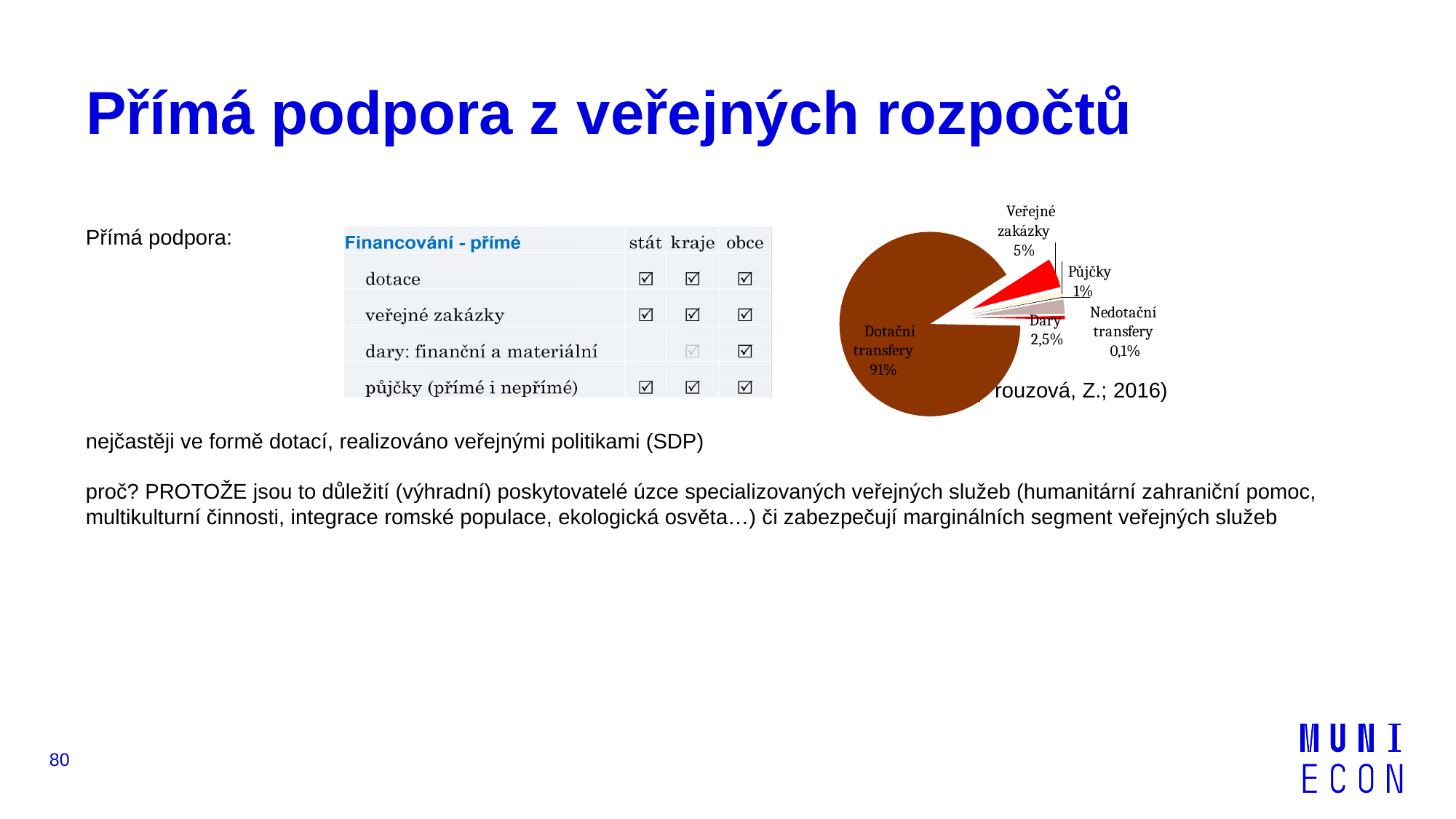
What share of the pie does Dary have? 2,5% What is the difference in percentage points between Veřejné zakázky and Půjčky? 4 What kind of chart is shown on the slide? pie chart What colour is the Dotační transfery slice in the pie chart? brown What share of the pie does Veřejné zakázky have? 5% Which is larger in the pie chart, Veřejné zakázky or Dary? Veřejné zakázky How many slices does the pie chart have? 6 Which slice of the pie chart is the smallest? Nedotační transfery Which slice of the pie chart is the largest? Dotační transfery What share of the pie does Půjčky have? 1%